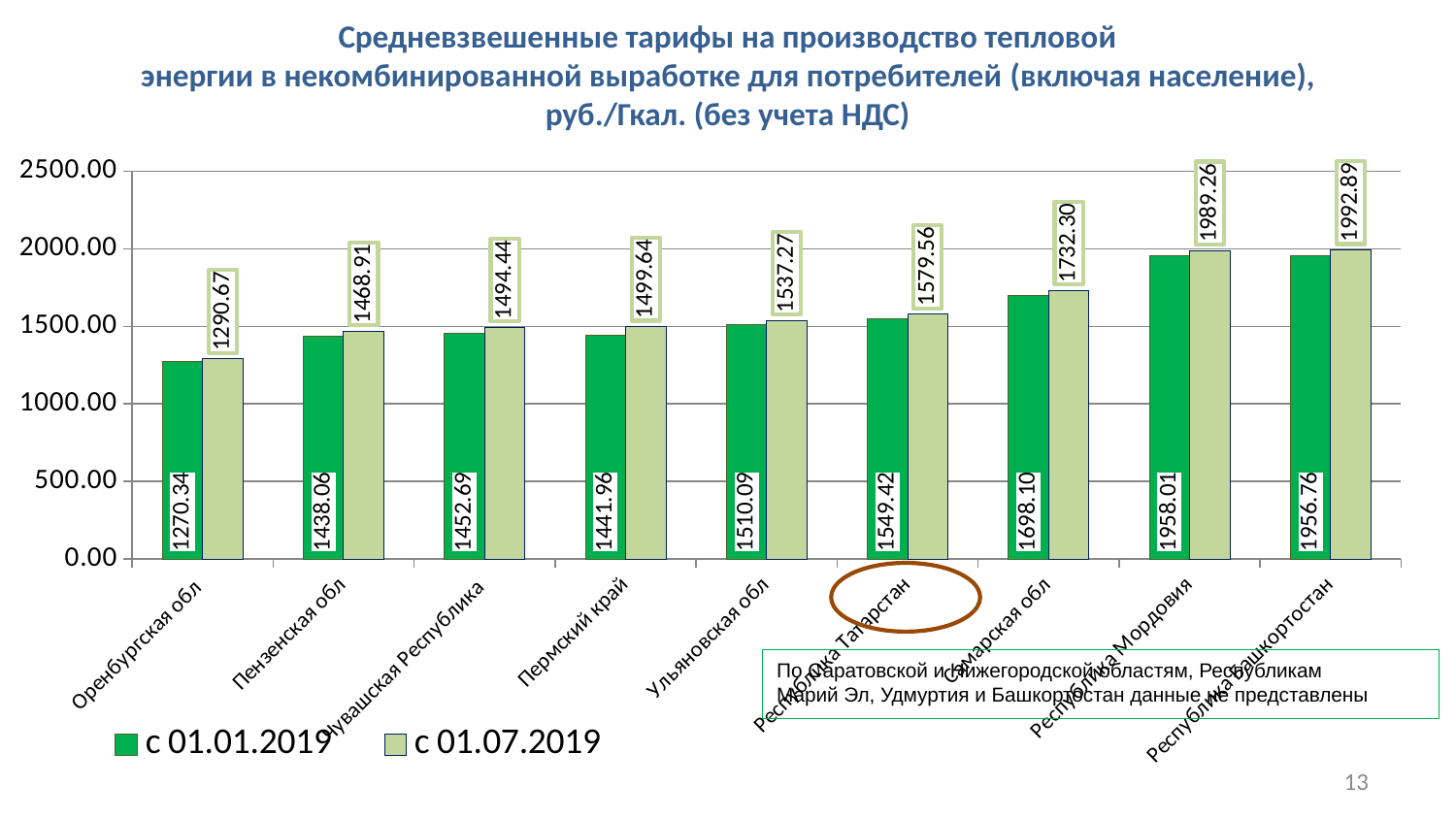
What kind of chart is shown on the slide? bar chart Is the value for Самарская обл in the series с 01.01.2019 greater or less than 1500.00? greater How many series does the legend list? 2 Which is larger in the series с 01.07.2019: Пермский край or Чувашская Республика? Пермский край What is the difference between the с 01.07.2019 and с 01.01.2019 values for Самарская обл? 34.20 Which region has the highest value in the series с 01.07.2019? Республика Башкортостан What is the difference between the с 01.07.2019 and с 01.01.2019 values for Республика Мордовия? 31.25 How many regions are shown on the x axis of the chart? 9 What is the value for Республика Татарстан in the series с 01.07.2019? 1579.56 What is the value for Оренбургская обл in the series с 01.01.2019? 1270.34 Which region has the lowest value in the series с 01.01.2019? Оренбургская обл What is the value for Пермский край in the series с 01.07.2019? 1499.64